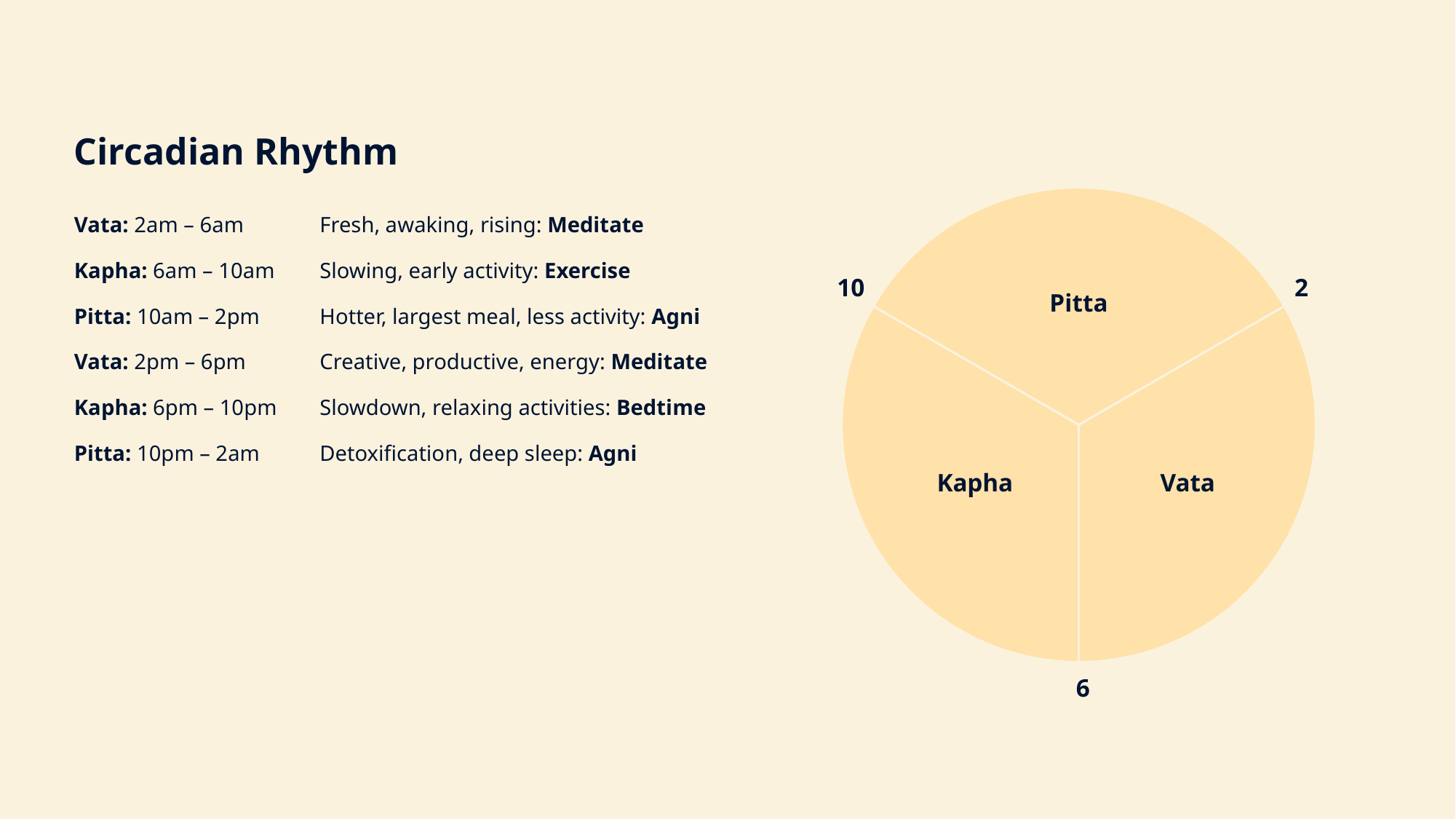
Which segment is at the top of the circle chart? Pitta How many segments does the circle chart have? 3 What kind of chart is shown on the right of the slide? Pie chart Which segment of the circle chart lies between the 6 and 10 markers? Kapha What number is printed below the circle chart? 6 Which segment of the circle chart lies between the 10 and 2 markers? Pitta Are the three segments of the circle chart equal in size, or is one larger than the others? Equal Which segment of the circle chart lies between the 2 and 6 markers? Vata